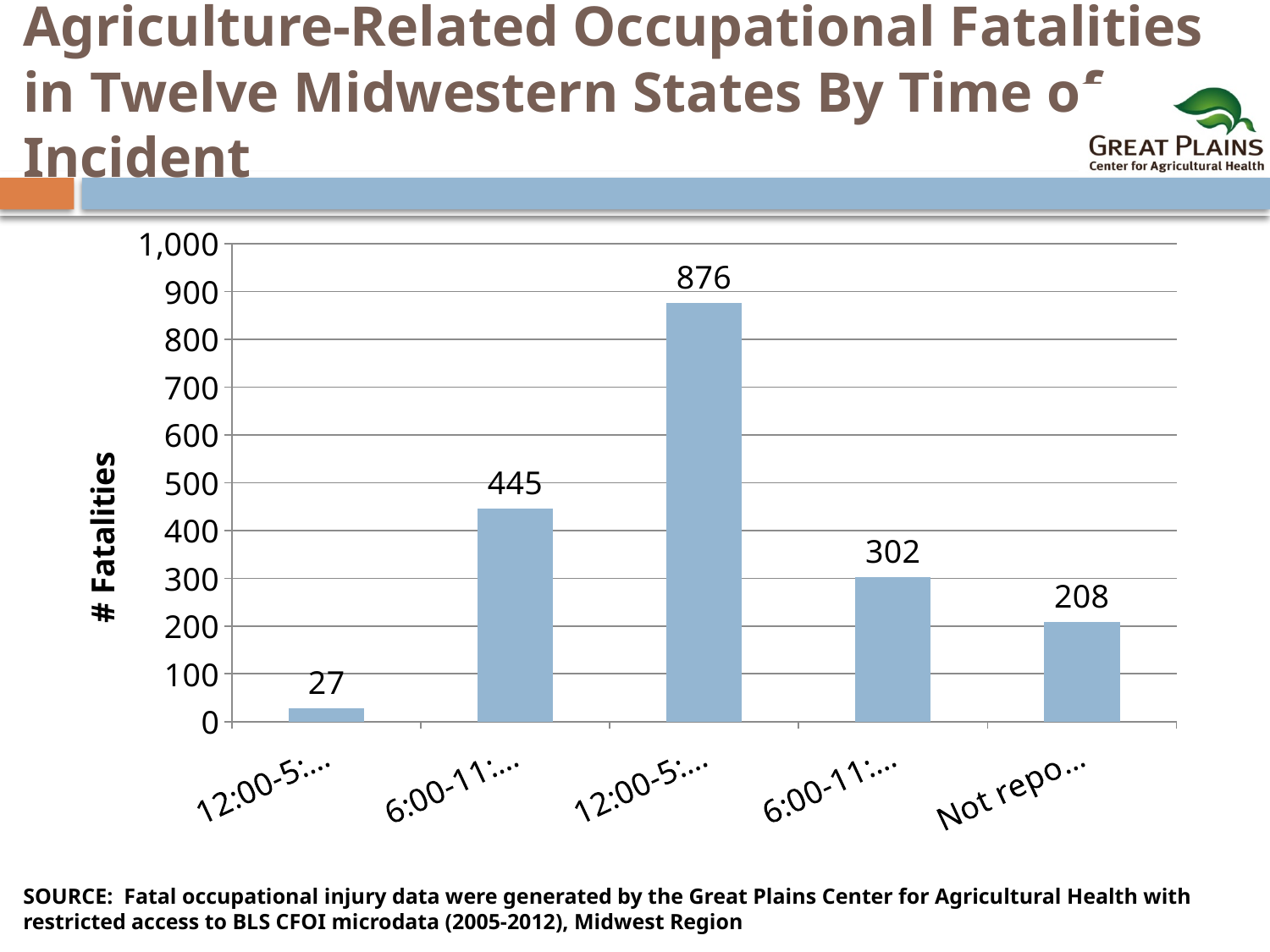
What is the difference between the third bar (876) and the second bar (445)? 431 What kind of chart is shown on the slide? Bar chart What is the value of the tallest bar in the chart? 876 What is the value of the second bar from the left in the chart? 445 What is the value of the rightmost bar in the chart? 208 What is the value of the shortest bar in the chart? 27 Which is larger: the fourth bar from the left or the rightmost bar? The fourth bar from the left (302) What is the value of the fourth bar from the left in the chart? 302 Is the value of the third bar from the left greater or less than 800? greater How many bars are plotted in the chart? 5 What is the value of the leftmost bar in the chart? 27 What is the label of the vertical axis of the chart? # Fatalities